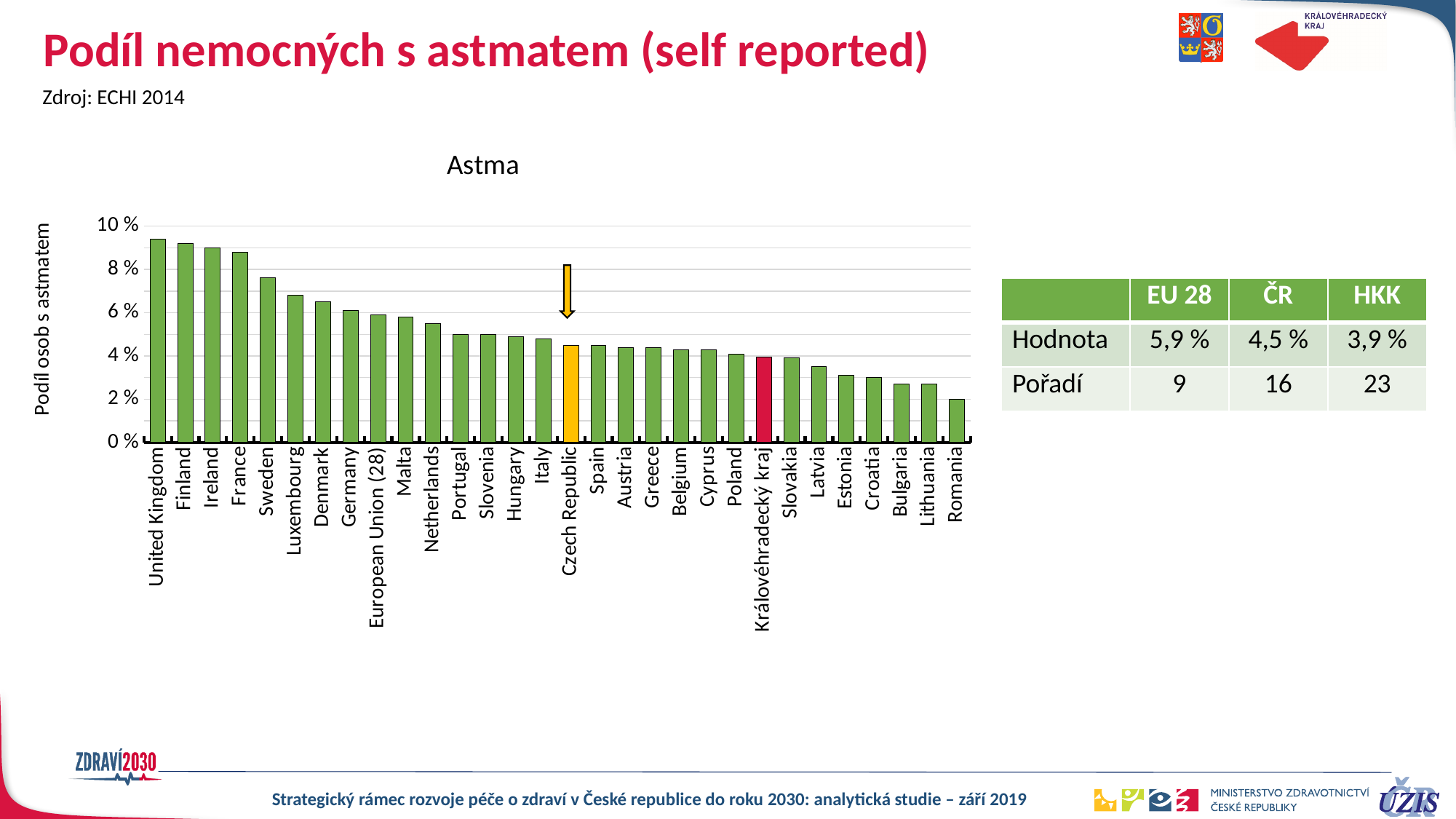
Which category has the lowest share of people with asthma? Romania According to the table, what is the value (Hodnota) for HKK? 3,9 % According to the table, what is the value (Hodnota) for ČR? 4,5 % Is the value for United Kingdom greater or less than 8 %? greater Is the value for Romania greater or less than 4 %? less How many countries/regions are plotted in the chart? 30 What type of chart is shown on the slide? bar chart Do the bar values rise or fall from left to right along the x axis? fall According to the table, what is the value (Hodnota) for EU 28? 5,9 % What is the title of the chart? Astma Which category has the highest share of people with asthma? United Kingdom What is the difference between the EU 28 value and the ČR value in the table? 1,4 %